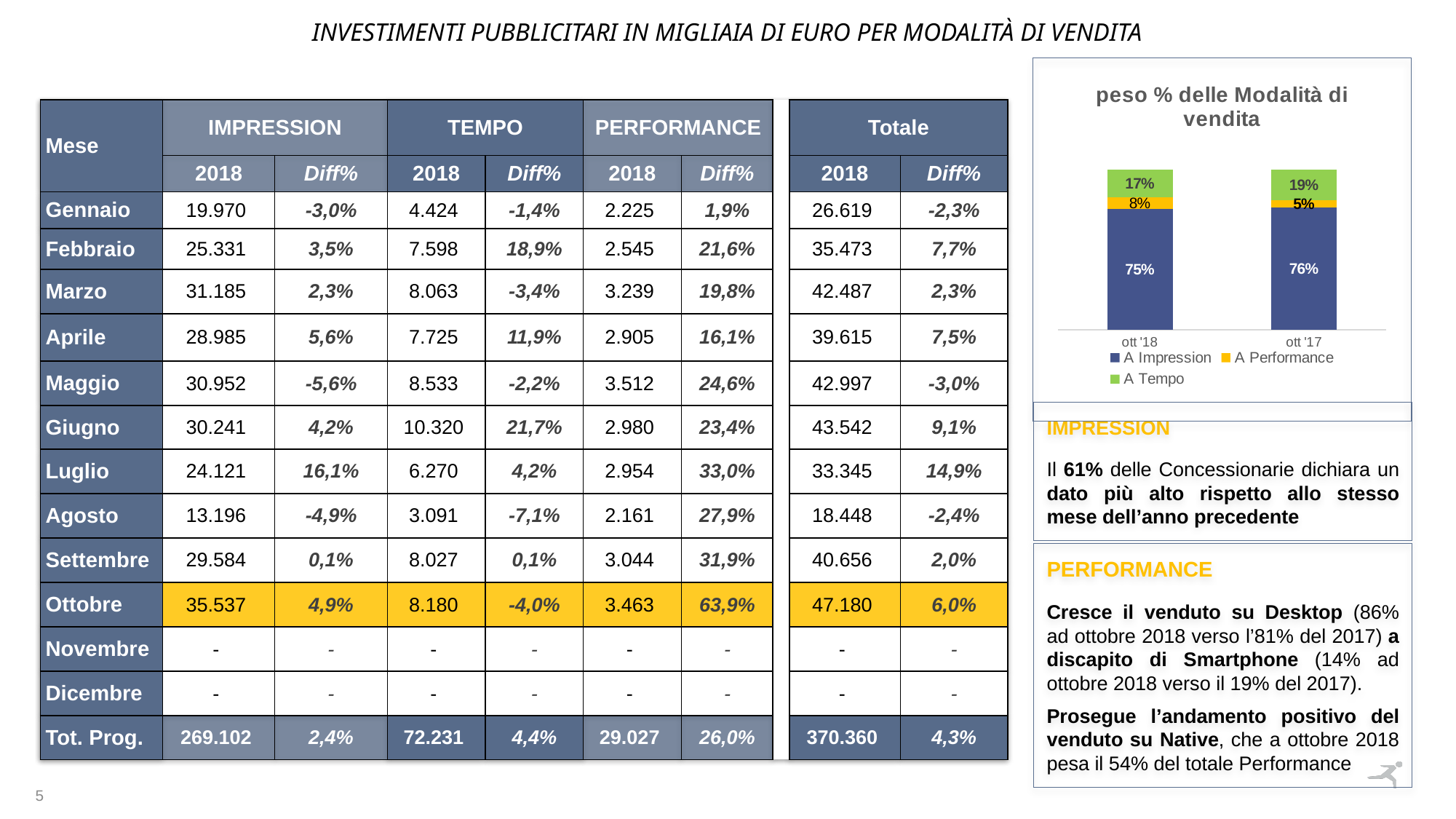
What is the value of A Tempo for ott '17 in the chart? 19% What kind of chart is shown on the slide? stacked bar chart What is the value of A Performance for ott '17 in the chart? 5% What is the value of A Performance for ott '18 in the chart? 8% How many series does the chart's legend list? 3 Which series has the smallest share in the ott '17 bar of the chart? A Performance What is the difference between the A Performance values for ott '18 and ott '17 in the chart? 3% Which series has the largest share in the ott '18 bar of the chart? A Impression What is the value of A Impression for ott '18 in the chart? 75% How many categories are shown on the x axis of the chart? 2 In the chart, is the A Tempo share larger for ott '18 or ott '17? ott '17 What is the title of the chart on the slide? peso % delle Modalità di vendita